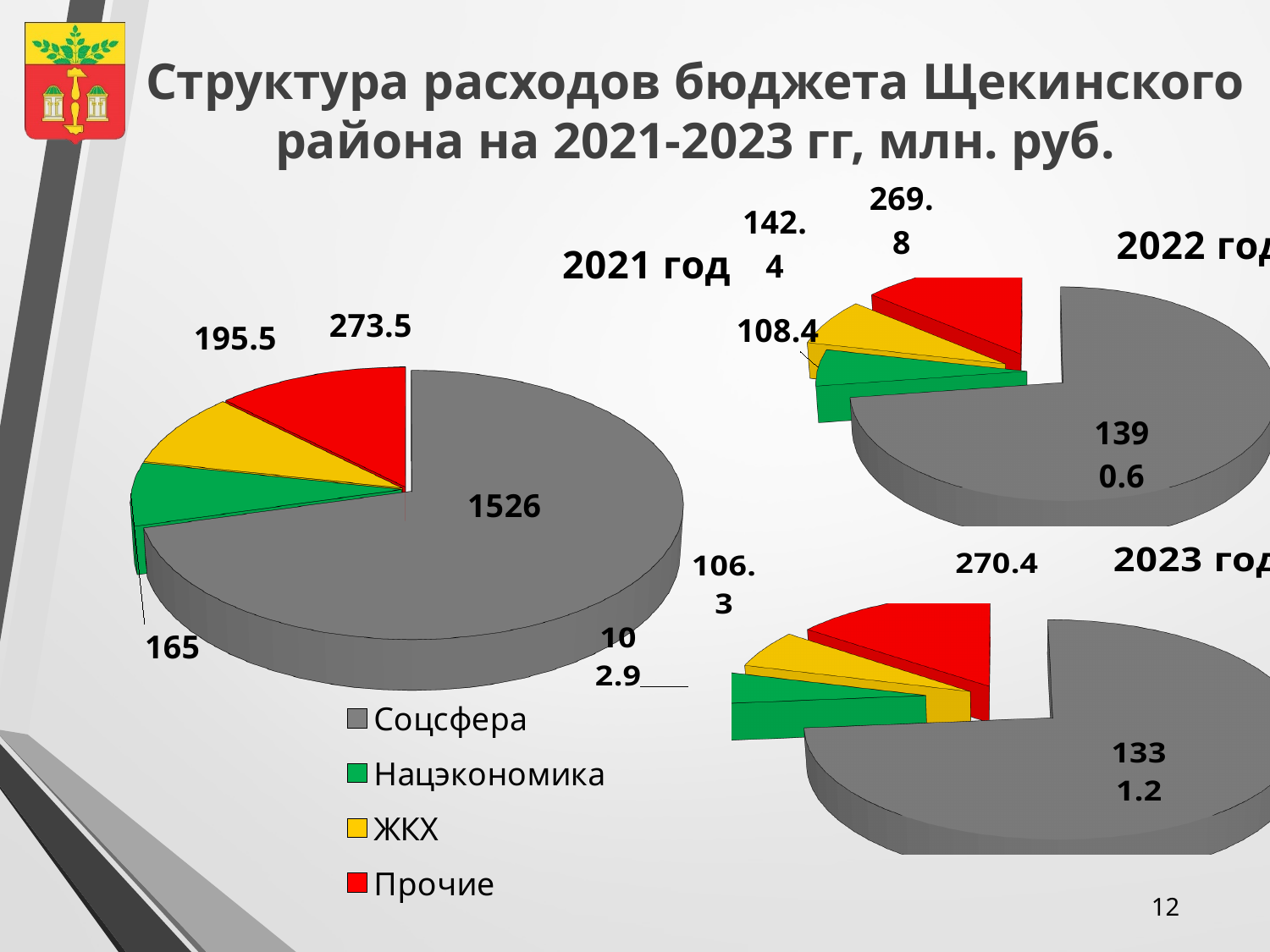
In the 2021 год chart, which category has the largest value? Соцсфера In the 2022 год chart, which is larger, Прочие or ЖКХ? Прочие In the 2021 год chart, what is the value for Прочие? 273.5 In the 2023 год chart, what is the value for Прочие? 270.4 What colour represents Прочие in the legend? red How many categories does the legend list? 4 In the 2021 год chart, which category has the smallest value? Нацэкономика How many pie charts are on the slide? 3 In the 2021 год chart, what is the difference between Прочие and ЖКХ? 78 In the 2022 год chart, what is the value for Нацэкономика? 108.4 What kind of chart is used for the 2021 год data? pie chart In the 2021 год chart, what is the value for Соцсфера? 1526